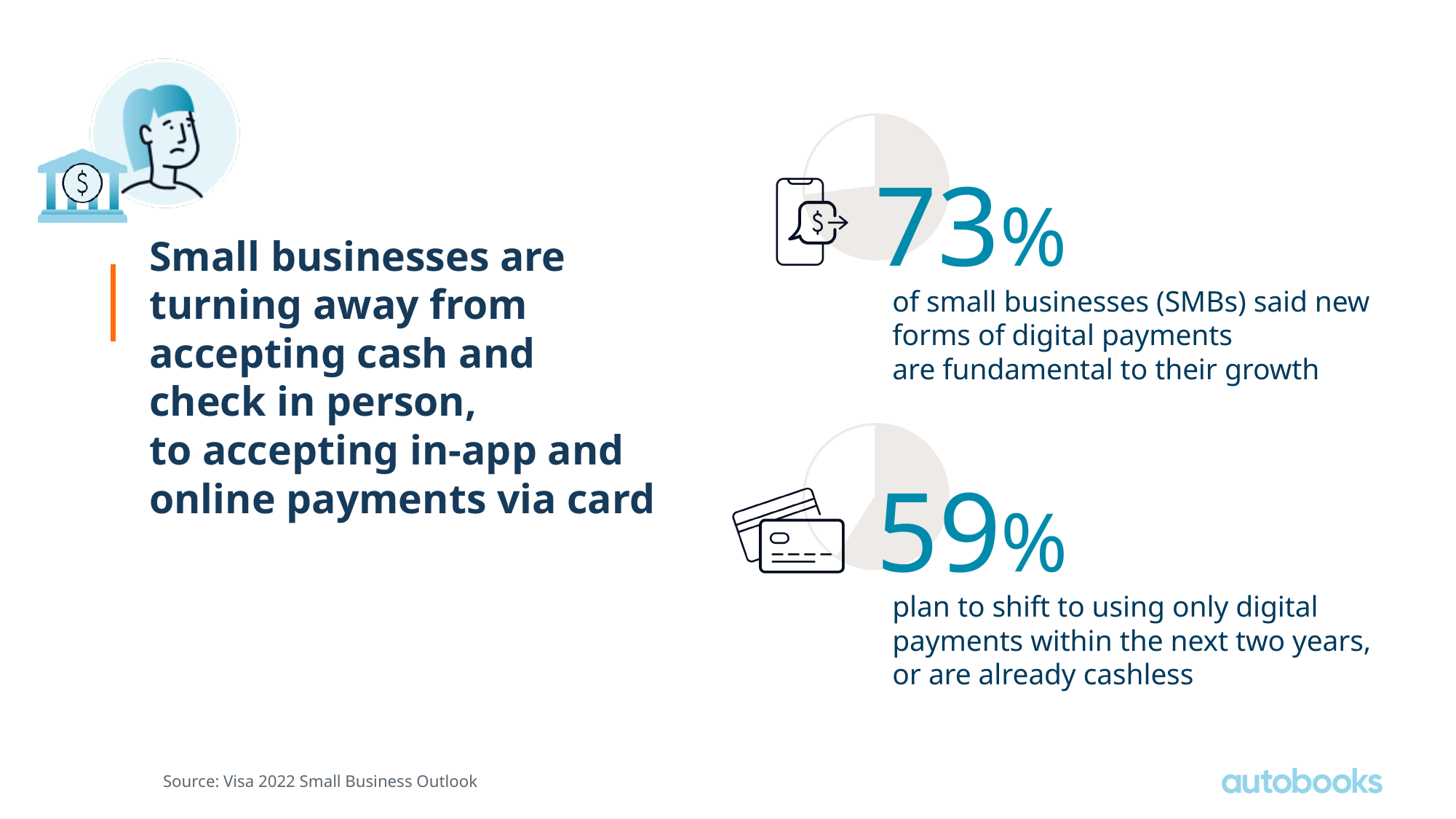
What percentage is shown on the upper pie chart next to the phone icon? 73% What icon appears next to the 59% pie chart? credit cards What percentage is shown on the lower pie chart next to the credit card icon? 59% Is the value on the upper pie chart (digital payments fundamental to growth) greater or less than 75%? less What source is cited for the statistics on the slide? Visa 2022 Small Business Outlook Which is larger: the percentage on the upper chart (digital payments fundamental to growth) or the percentage on the lower chart (plan to shift to only digital payments)? the upper chart (73%) What kind of chart is used to illustrate the 73% and 59% statistics? pie chart Is the value on the lower pie chart (plan to shift to only digital payments) greater or less than 50%? greater What is the difference between the 73% on the upper chart and the 59% on the lower chart? 14 percentage points What share of small businesses plan to shift to using only digital payments within the next two years, or are already cashless? 59% How many pie charts are shown on the slide? 2 What share of small businesses said new forms of digital payments are fundamental to their growth? 73%